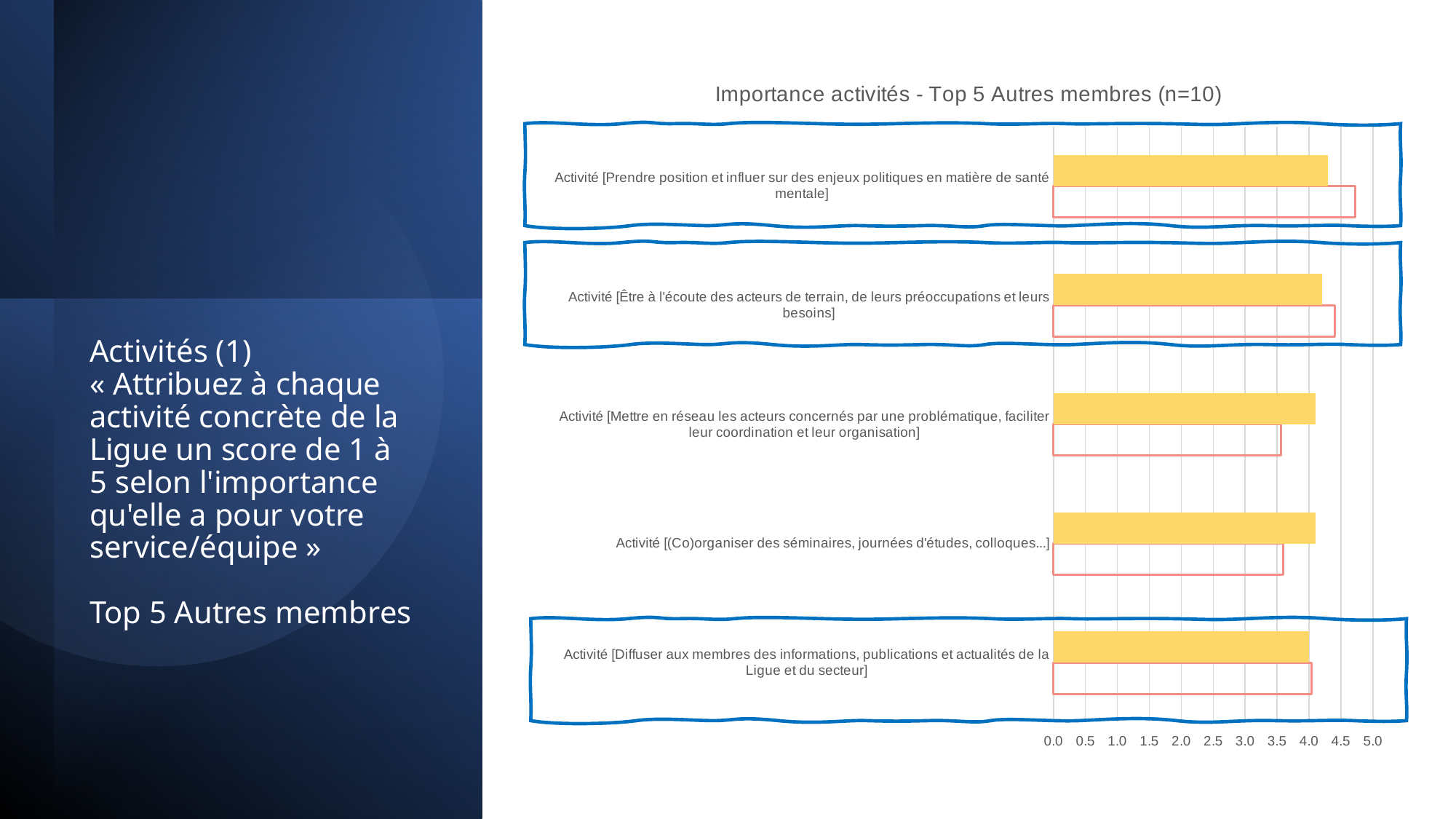
For 'Activité [Mettre en réseau les acteurs concernés par une problématique, faciliter leur coordination et leur organisation]', which bar is longer, the yellow bar or the red-outlined bar? the yellow bar Is the red-outlined bar for 'Activité [Prendre position et influer sur des enjeux politiques en matière de santé mentale]' greater or less than 4.5? greater How many activity categories are plotted in the chart? 5 Which activity has the longest red-outlined bar? Activité [Prendre position et influer sur des enjeux politiques en matière de santé mentale] Is the yellow bar for 'Activité [Prendre position et influer sur des enjeux politiques en matière de santé mentale]' greater or less than 4.0? greater What kind of chart is shown on the slide? bar chart Is the red-outlined bar for 'Activité [(Co)organiser des séminaires, journées d'études, colloques...]' greater or less than 4.0? less For 'Activité [Prendre position et influer sur des enjeux politiques en matière de santé mentale]', which bar is longer, the yellow bar or the red-outlined bar? the red-outlined bar How many bars are shown for each activity category? 2 What is the title of the chart? Importance activités - Top 5 Autres membres (n=10)